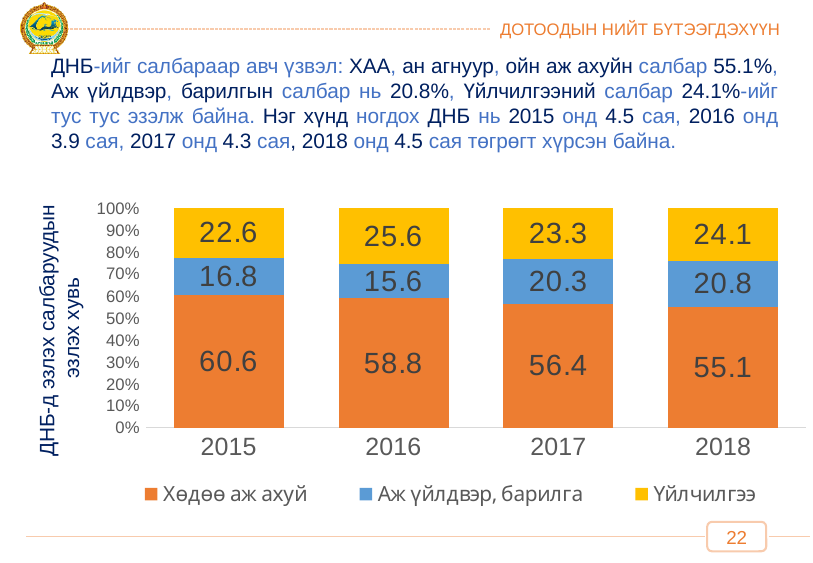
What is the value for Үйлчилгээ in 2016? 25.6 Does the Хөдөө аж ахуй value rise or fall from 2015 to 2018? Fall Which colour represents Үйлчилгээ in the chart? Yellow How many years are shown on the x axis? 4 How many series does the legend list? 3 What is the value for Аж үйлдвэр, барилга in 2017? 20.3 Which is larger, the Үйлчилгээ value in 2016 or in 2018? 2016 In which year is the Аж үйлдвэр, барилга value the lowest? 2016 What is the value for Хөдөө аж ахуй in 2015? 60.6 In which year is the Хөдөө аж ахуй value the highest? 2015 What is the difference between the Хөдөө аж ахуй values for 2015 and 2018? 5.5 What kind of chart is shown on the slide? Stacked bar chart